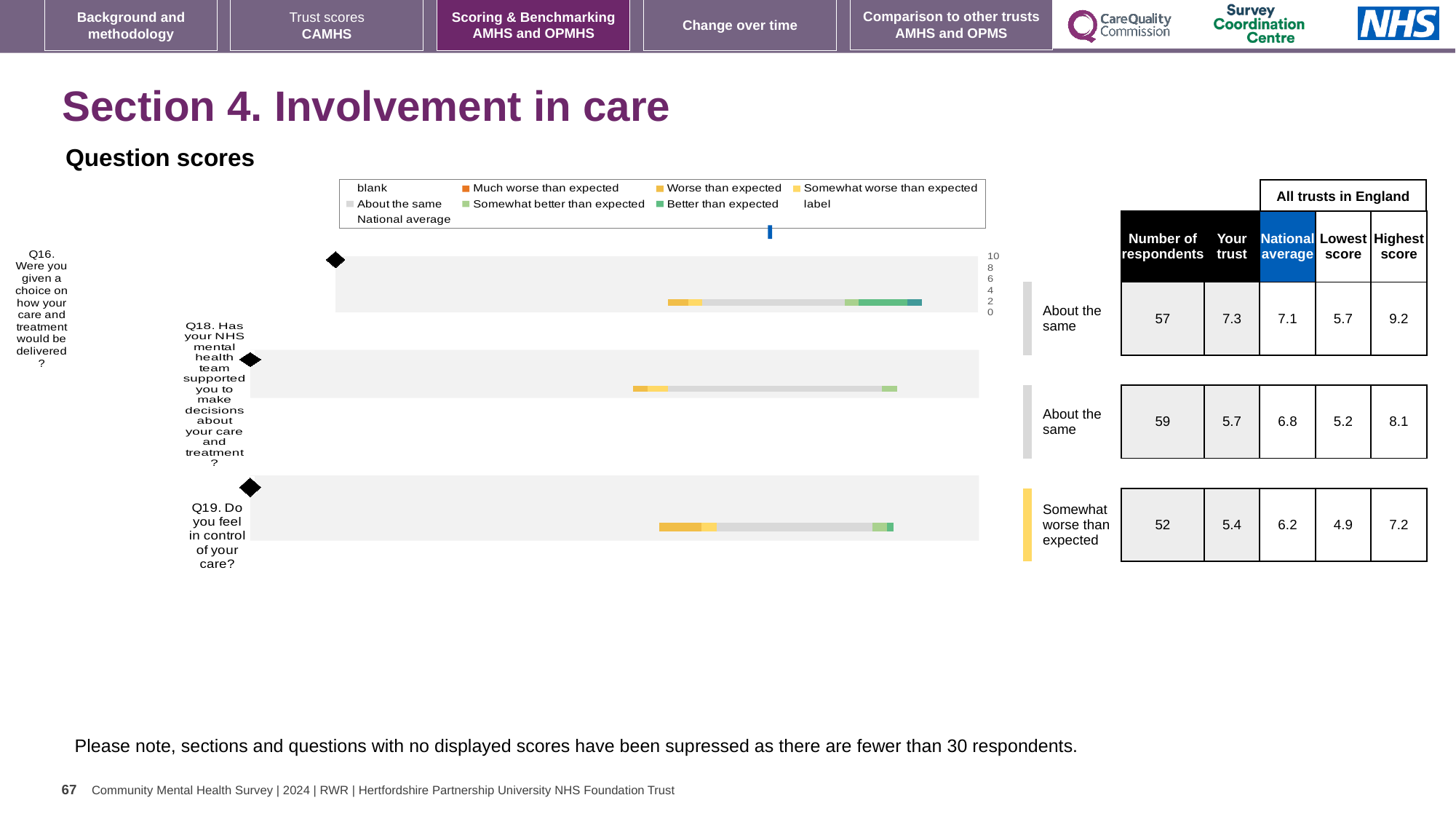
In the table next to the chart, what is the 'Your trust' score for Q16 (Were you given a choice on how your care and treatment would be delivered?)? 7.3 What type of chart is used to show the question scores on this slide? bar chart Which of the three questions has the fewest respondents? Q19 In the table next to the chart, what is the national average for Q18 (Has your NHS mental health team supported you to make decisions about your care and treatment?)? 6.8 In the table next to the chart, how many respondents answered Q19 (Do you feel in control of your care?)? 52 How many survey questions are plotted in the question scores chart? 3 For Q19, which is larger: the 'Your trust' score or the national average? National average What is the difference between the highest score (9.2) and the lowest score (5.7) for Q16? 3.5 What is the maximum value shown on the chart's score axis? 10 What is the highest score across all trusts in England for Q16? 9.2 What benchmark category is shown for Q19 (Do you feel in control of your care?)? Somewhat worse than expected Which of the three questions has the highest 'Your trust' score? Q16